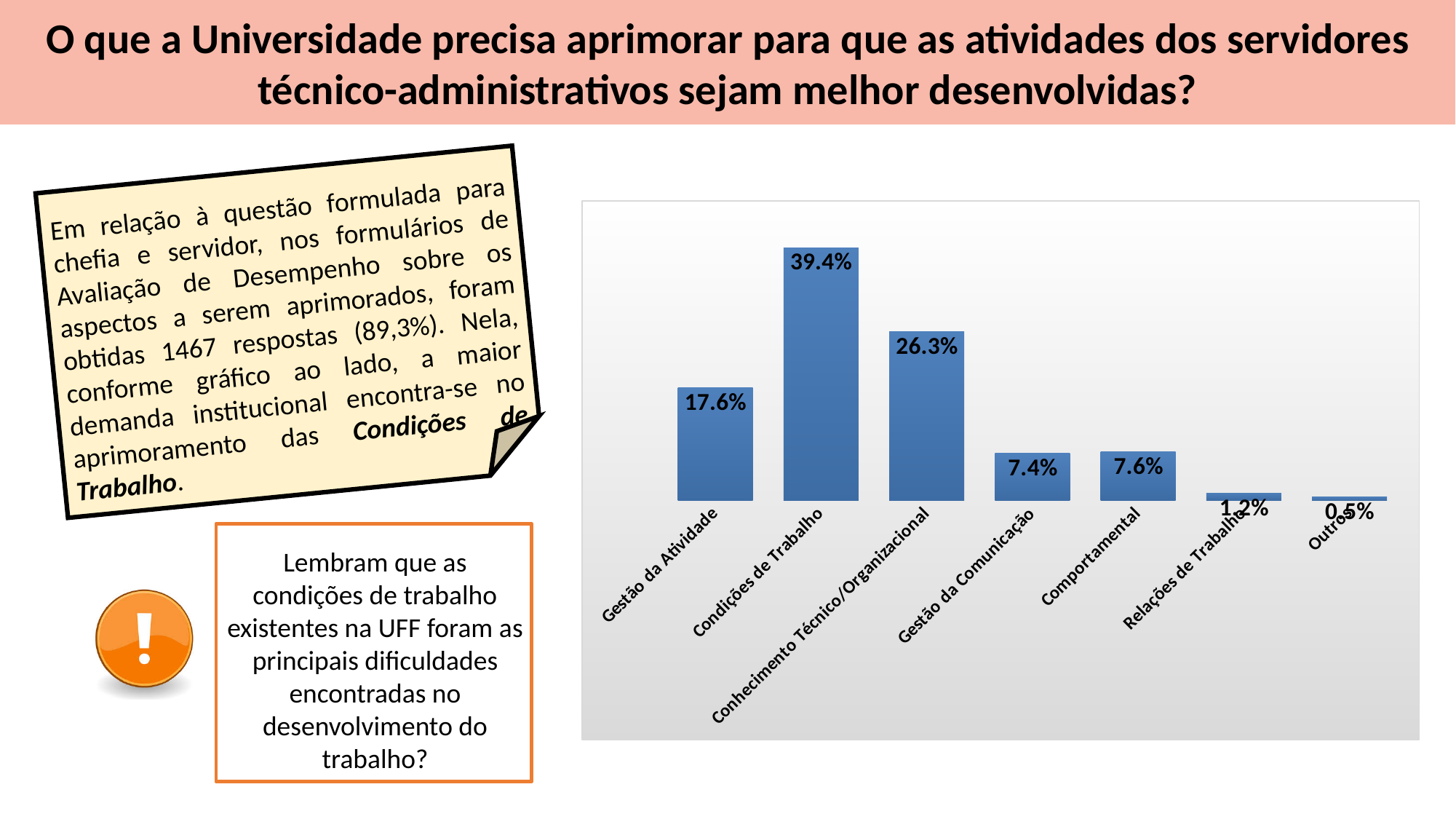
What kind of chart is shown on the slide? Bar chart What is the value for Condições de Trabalho? 39.4% How many categories are shown in the chart? 7 Which is larger, Gestão da Atividade or Conhecimento Técnico/Organizacional? Conhecimento Técnico/Organizacional Which category has the highest value? Condições de Trabalho What is the difference between Gestão da Atividade and Gestão da Comunicação? 10.2% What is the value for Relações de Trabalho? 1.2% What is the value for Comportamental? 7.6% What is the value for Conhecimento Técnico/Organizacional? 26.3% What is the value for Gestão da Atividade? 17.6% What is the difference between Condições de Trabalho and Conhecimento Técnico/Organizacional? 13.1% Which category has the lowest value? Outros